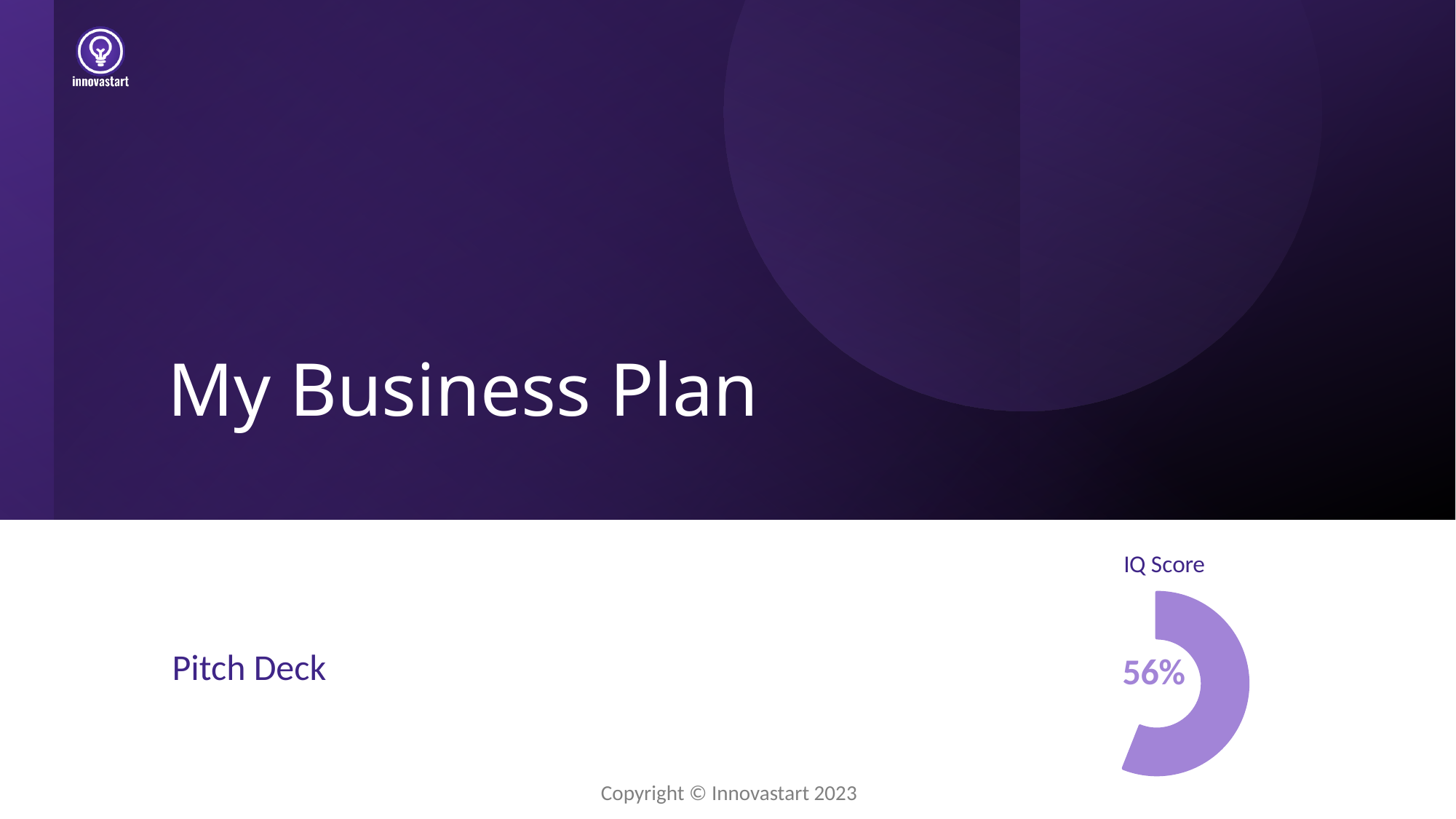
What is the title of the chart on the slide? IQ Score What kind of chart is the IQ Score chart? doughnut chart Is the value shown on the IQ Score chart greater or less than 50%? greater What share of the IQ Score doughnut does the filled purple segment represent? 56% What colour is the filled segment of the IQ Score chart? purple What value is shown on the IQ Score chart? 56%